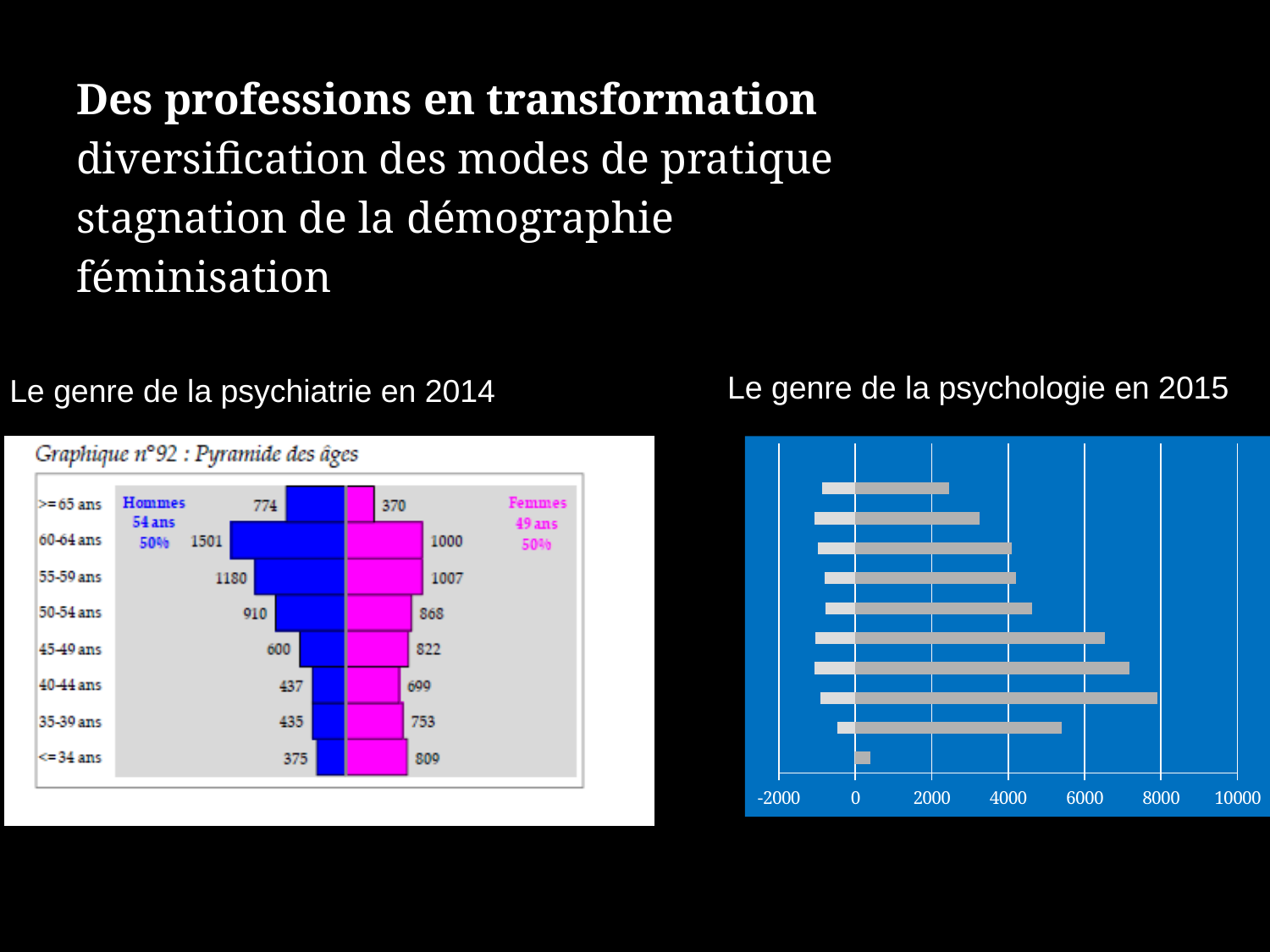
In the chart 'Le genre de la psychiatrie en 2014', how many women (Femmes) are in the >=65 ans age group? 370 In the chart 'Le genre de la psychiatrie en 2014', are there more men or more women in the 45-49 ans age group? Women (Femmes) In the chart 'Le genre de la psychiatrie en 2014', how many age groups are shown? 8 In the chart 'Le genre de la psychiatrie en 2014', how many men (Hommes) are in the 60-64 ans age group? 1501 In the chart 'Le genre de la psychiatrie en 2014', what is the difference between the number of men and the number of women in the 60-64 ans age group? 501 What kind of chart is 'Le genre de la psychologie en 2015'? Bar chart In the chart 'Le genre de la psychiatrie en 2014', which age group has the highest number of men (Hommes)? 60-64 ans In the chart 'Le genre de la psychiatrie en 2014', how many women (Femmes) are in the <=34 ans age group? 809 In the chart 'Le genre de la psychiatrie en 2014', what is the total number of men and women in the 55-59 ans age group? 2187 In the chart 'Le genre de la psychologie en 2015', how many bars are plotted? 10 In the chart 'Le genre de la psychiatrie en 2014', what is the average age given for women (Femmes)? 49 ans In the chart 'Le genre de la psychiatrie en 2014', which age group has the lowest number of women (Femmes)? >=65 ans